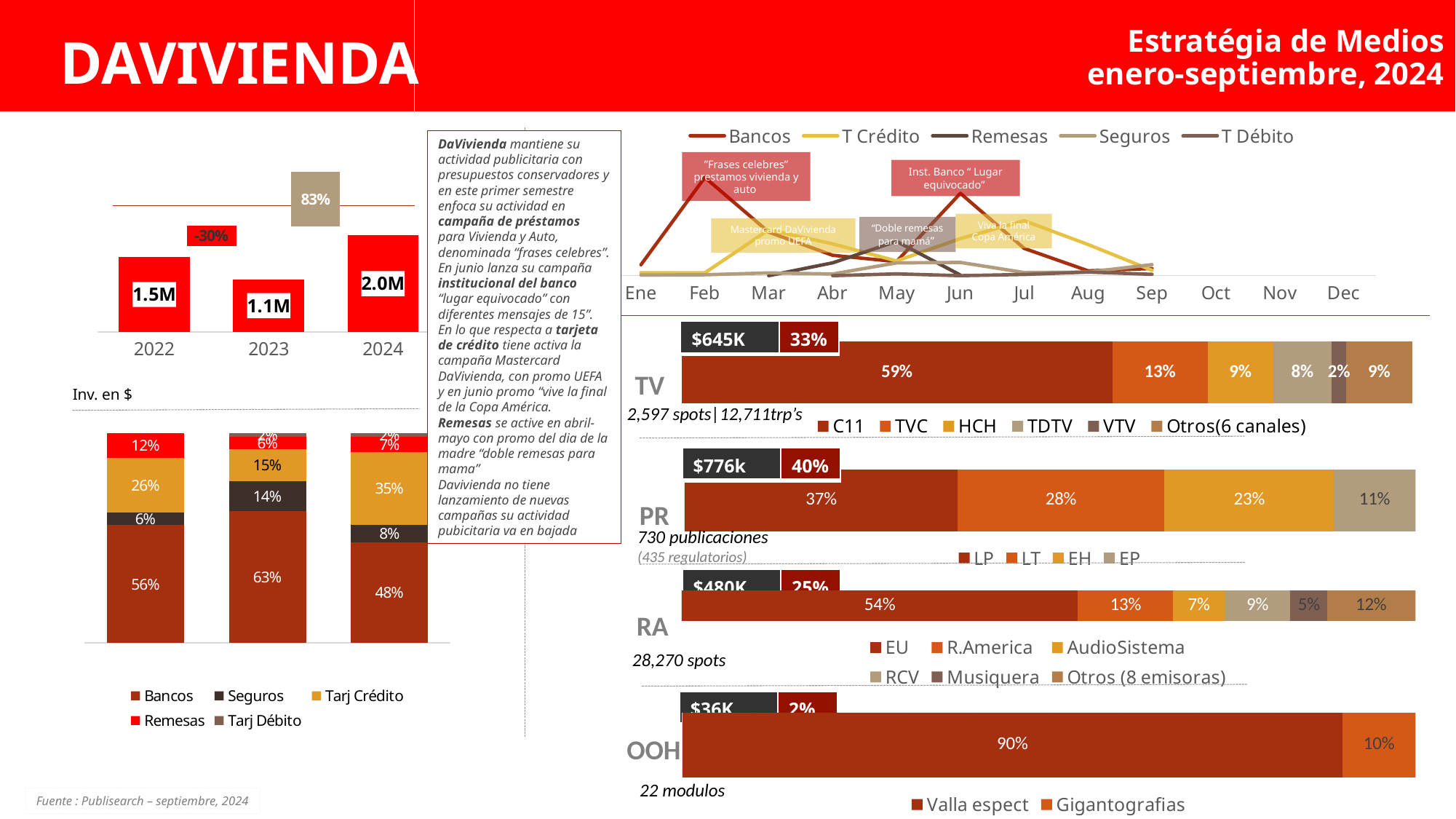
In the stacked bar chart at the bottom left, what is the share of Bancos in 2023? 63% In the stacked bar chart at the bottom left, what is the share of Tarj Crédito in 2024? 35% In the 'Inv. en $' bar chart on the left, how many years are shown? 3 In the stacked bar chart at the bottom left, which is larger: Seguros in 2023 or Seguros in 2024? Seguros in 2023 In the TV horizontal bar on the right, what is the share of C11? 59% In the 'Inv. en $' bar chart on the left, what percentage change is shown between 2023 and 2024? 83% In the 'Inv. en $' bar chart on the left, which year has the lowest investment? 2023 In the RA horizontal bar on the right, which station has the highest share? EU In the OOH horizontal bar on the right, what is the share of Gigantografias? 10% In the PR horizontal bar on the right, what is the difference between the LP share and the LT share? 9% In the stacked bar chart at the bottom left, how many series does the legend list? 5 In the 'Inv. en $' bar chart on the left, what is the value for 2024? 2.0M